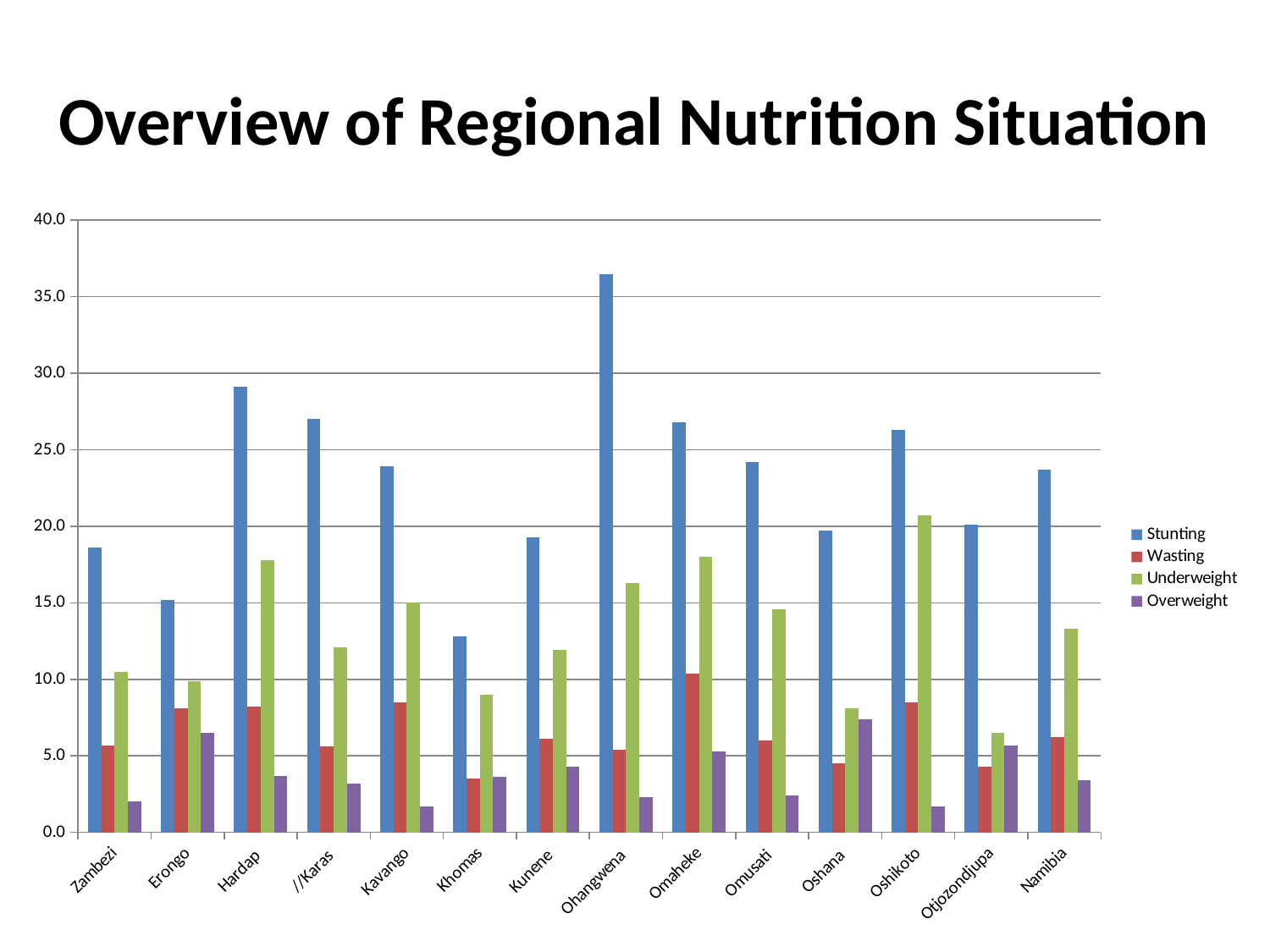
How many categories are shown along the x axis? 14 How many series does the legend list? 4 What kind of chart is shown on the slide? bar chart Which category has the highest Wasting value? Omaheke Which category has the lowest Stunting value? Khomas Which category has the highest Stunting value? Ohangwena What is the title of the chart? Overview of Regional Nutrition Situation Which is larger, the Stunting value for Hardap or the Stunting value for Kavango? Hardap Is the Overweight value for Zambezi greater or less than 5.0? less Is the Stunting value for Ohangwena greater or less than 35.0? greater Which category has the highest Overweight value? Oshana